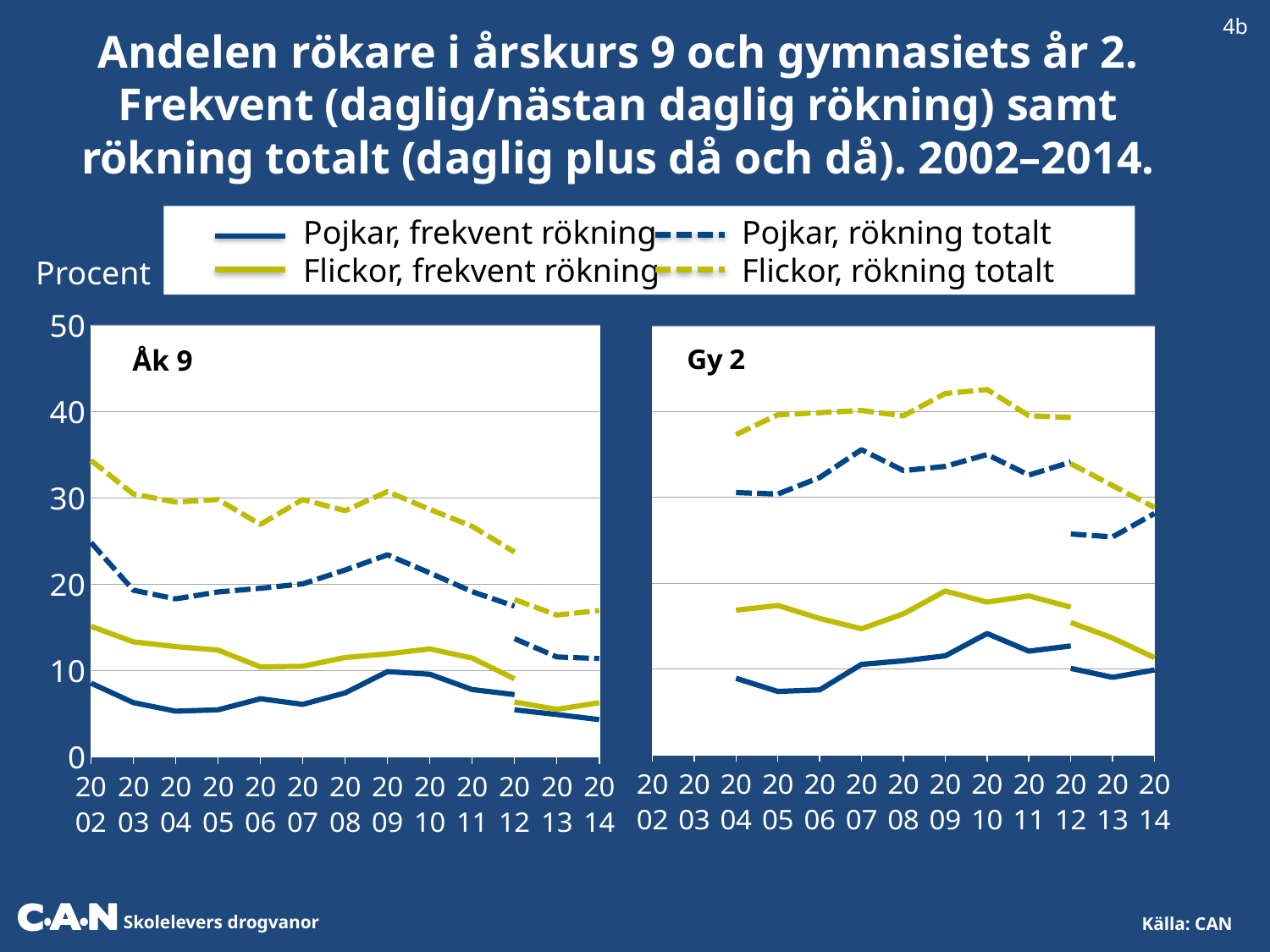
In the Åk 9 chart, is the value for Pojkar, frekvent rökning in 2014 greater or less than 10? less In the Gy 2 chart, is the value for Flickor, rökning totalt in 2010 greater or less than 40? greater How many years are shown on the x axis of the Åk 9 chart? 13 What is the label on the y axis of the charts? Procent How many series does the legend list? 4 In the Åk 9 chart, does Flickor, rökning totalt rise or fall overall from 2002 to 2014? Fall In the Gy 2 chart, which series has the highest value in 2010? Flickor, rökning totalt What source is given for the charts at the bottom of the slide? Källa: CAN In the Åk 9 chart, which is higher in 2002: Flickor, rökning totalt or Pojkar, rökning totalt? Flickor, rökning totalt In the Gy 2 chart, is the value for Pojkar, frekvent rökning in 2005 greater or less than 10? less What kind of chart is the Åk 9 chart on the left? Line chart